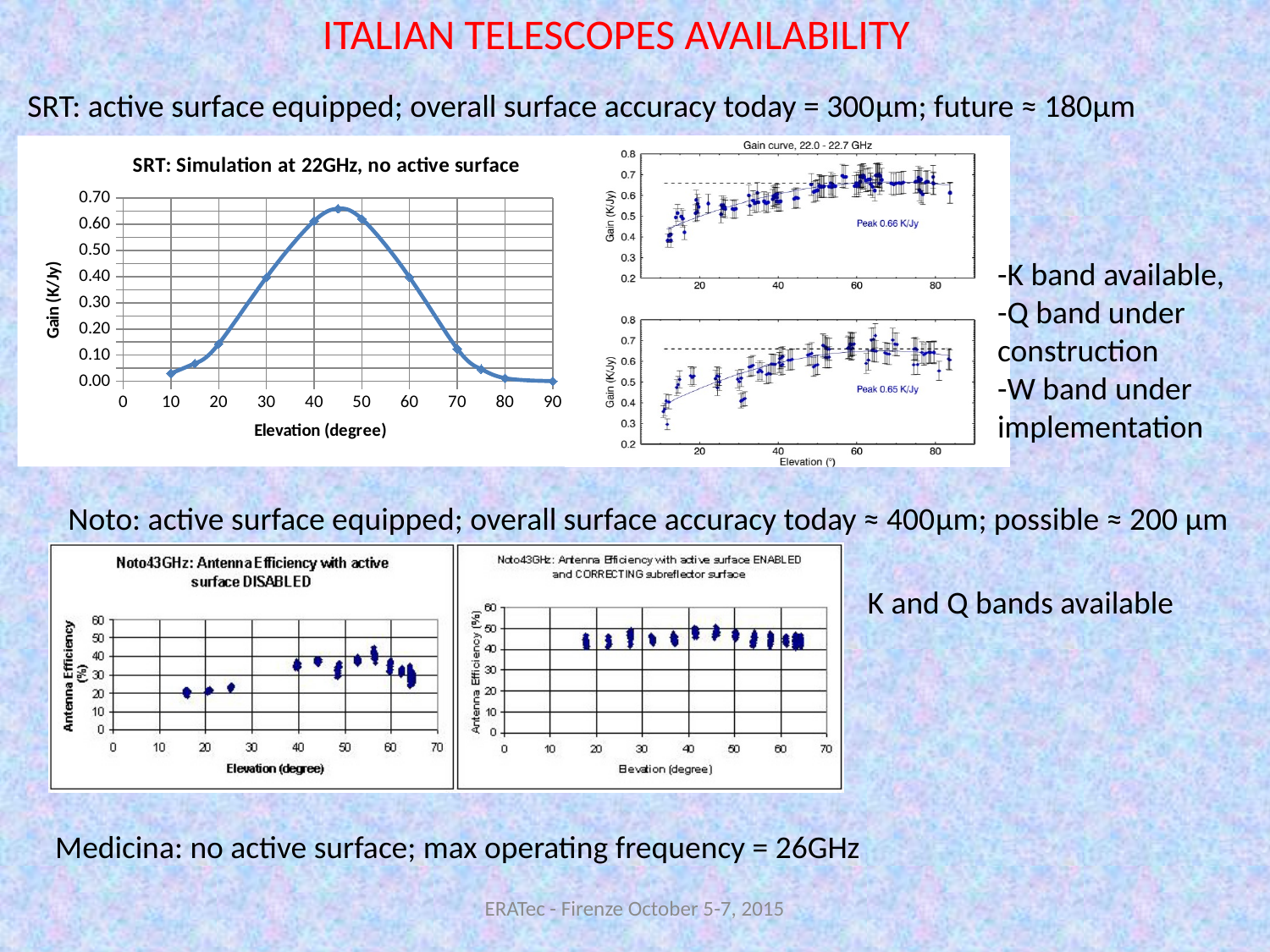
In the top 'Gain curve, 22.0 - 22.7 GHz' chart, what peak gain value is printed? 0.66 K/Jy In the 'SRT: Simulation at 22GHz, no active surface' chart, at which elevation (degree) is the gain highest? 45 In the 'SRT: Simulation at 22GHz, no active surface' chart, is the gain at 45 degrees elevation greater or less than 0.60? greater In the 'SRT: Simulation at 22GHz, no active surface' chart, is the gain at 20 degrees elevation greater or less than 0.20? less What kind of chart is the 'SRT: Simulation at 22GHz, no active surface' chart? line chart In the 'SRT: Simulation at 22GHz, no active surface' chart, is the gain at 30 degrees elevation greater or less than 0.30? greater In the 'SRT: Simulation at 22GHz, no active surface' chart, which has the larger gain: 40 degrees or 70 degrees elevation? 40 degrees In the lower gain curve chart on the right of the SRT section, what peak gain value is printed? 0.65 K/Jy What is the label of the vertical axis in the 'SRT: Simulation at 22GHz, no active surface' chart? Gain (K/Jy) In the 'SRT: Simulation at 22GHz, no active surface' chart, how does the gain change as elevation increases from 50 to 90 degrees? it falls